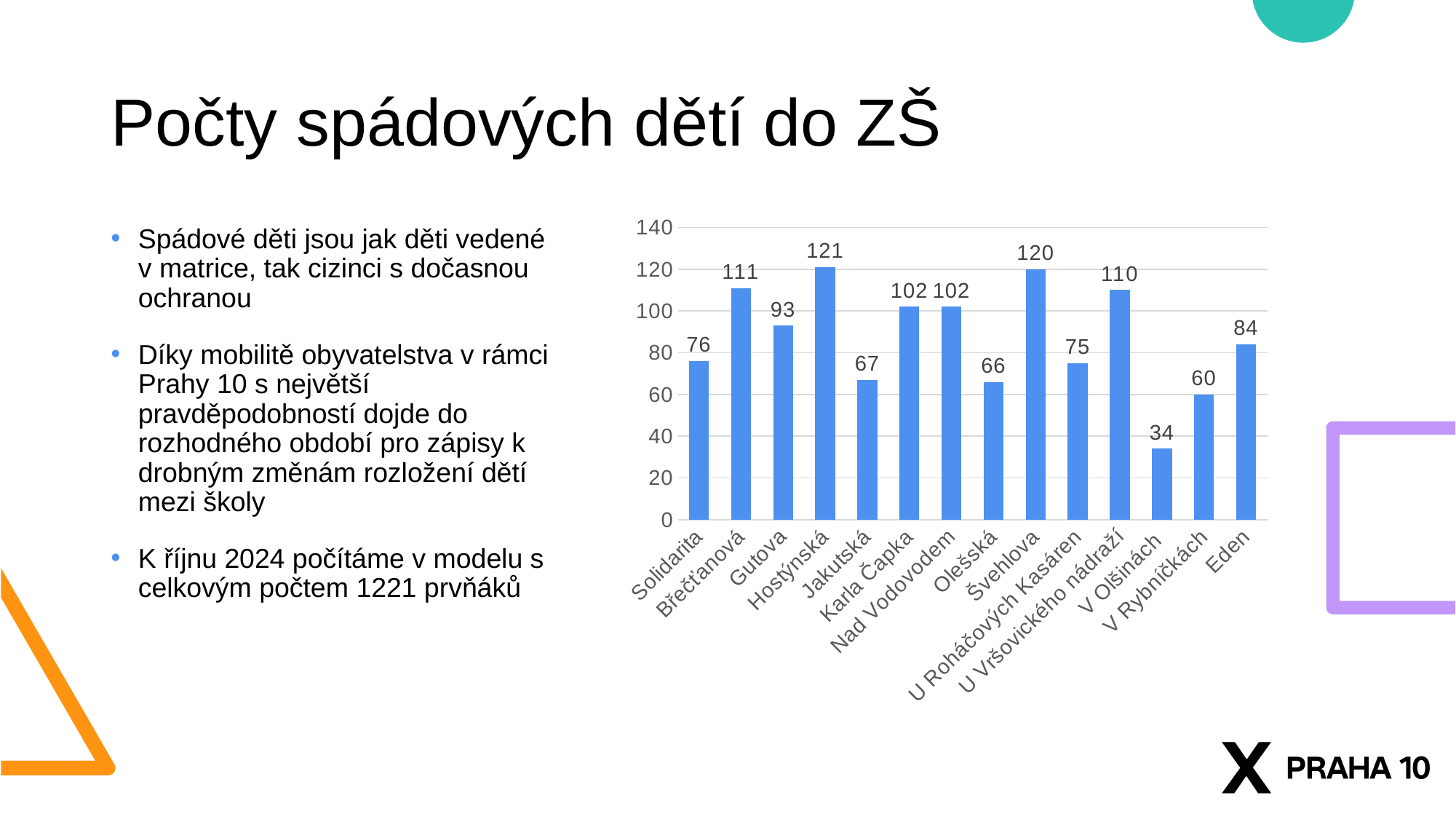
What is the value for U Roháčových Kasáren? 75 What kind of chart is shown on the slide? bar chart What is the value for V Olšinách? 34 Which category has the lowest value? V Olšinách What is the difference between the values for Hostýnská and V Olšinách? 87 How many categories are shown on the x axis? 14 What is the value for Hostýnská? 121 What is the difference between the values for Břečťanová and Gutova? 18 Which category has the highest value? Hostýnská Which is larger, the value for Švehlova or the value for U Vršovického nádraží? Švehlova Is the value for Jakutská greater or less than 80? less What is the value for Eden? 84